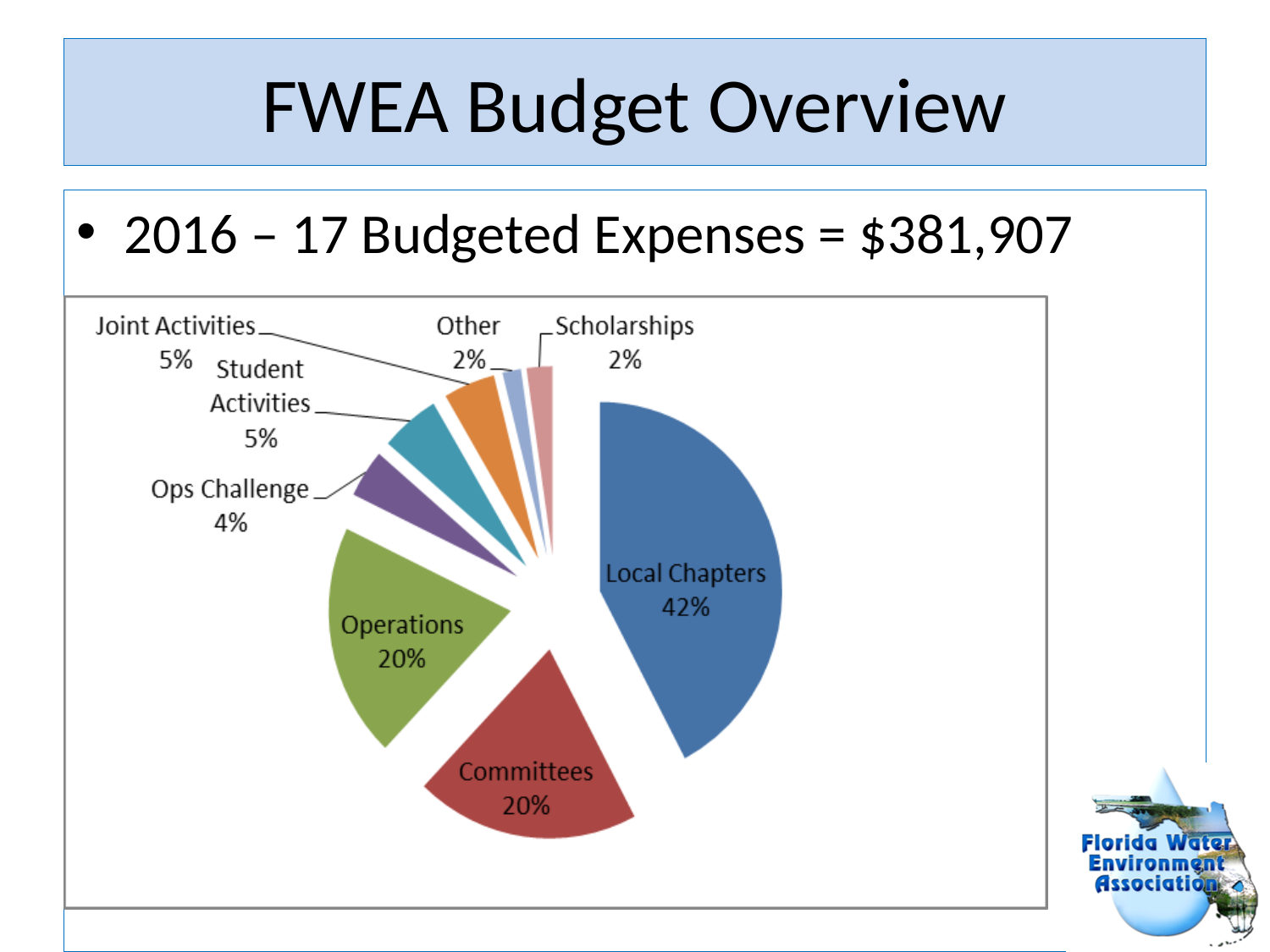
What percentage is shown for Scholarships? 2% What percentage is shown for Student Activities? 5% What colour is the Local Chapters slice? Blue What percentage is shown for Operations? 20% What share of the pie does Local Chapters represent? 42% What kind of chart is shown on the slide? Pie chart How many slices does the pie chart have? 8 What percentage is shown for Committees? 20% Which category has the largest slice of the pie? Local Chapters What percentage is shown for Ops Challenge? 4% Which is larger, the slice for Joint Activities or the slice for Ops Challenge? Joint Activities What is the difference in percentage points between Local Chapters and Operations? 22